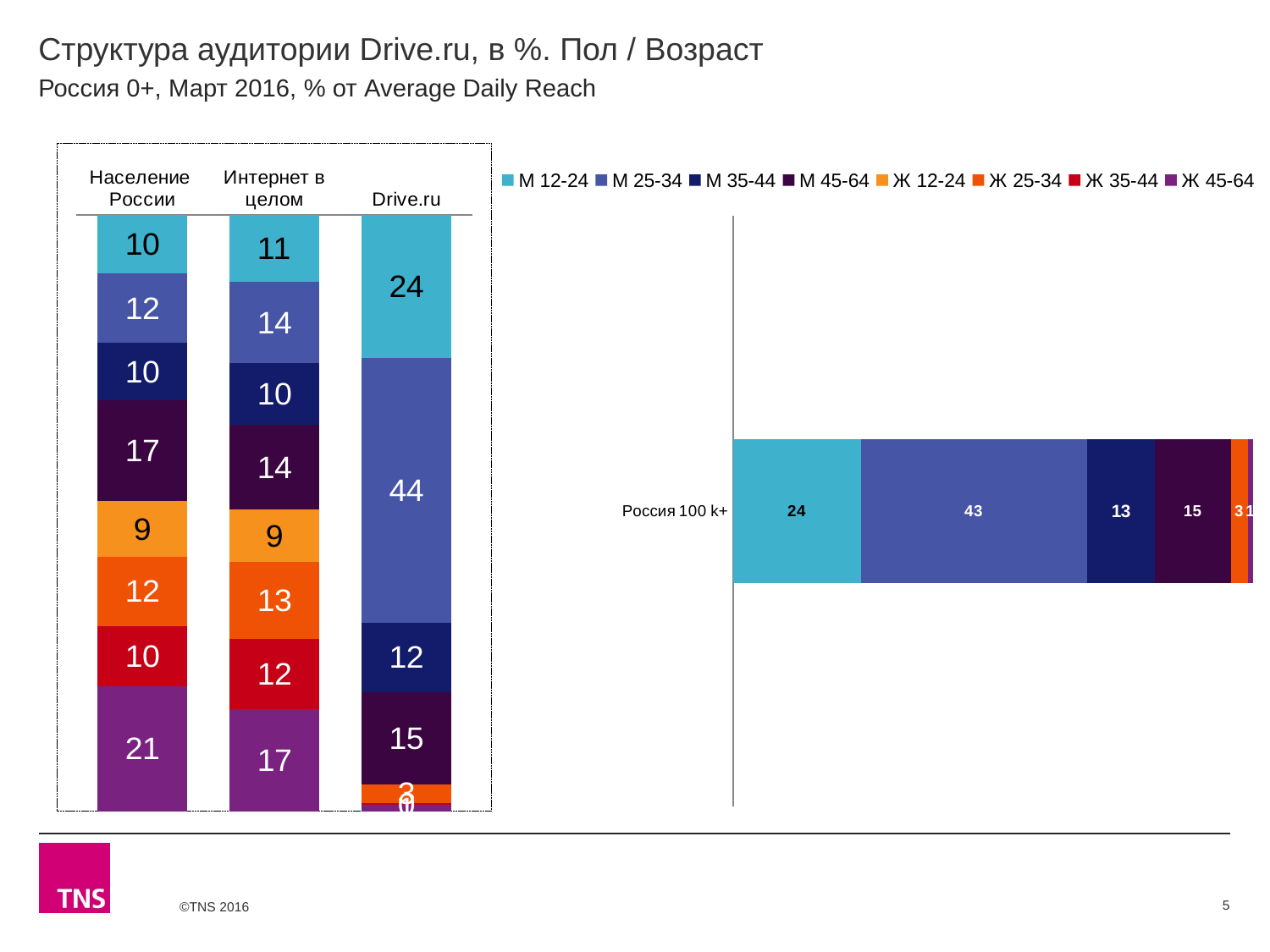
In the left chart, what is the value of Ж 45-64 for Интернет в целом? 17 In the left chart, what is the difference between the М 12-24 value for Drive.ru and the М 12-24 value for Население России? 14 In the right chart, what is the value of М 25-34 for Россия 100 k+? 43 In the left chart, what is the value of М 25-34 for Drive.ru? 44 What kind of chart is the left chart? Stacked bar chart How many categories (bars) are shown in the left chart? 3 In the left chart, which is larger: the М 35-44 value for Drive.ru or for Интернет в целом? Drive.ru In the left chart, which series has the largest value for Население России? Ж 45-64 In the right chart, which series has the largest segment for Россия 100 k+? М 25-34 In the left chart, what is the value of М 45-64 for Население России? 17 How many series does the legend list? 8 In the right chart, what is the value of М 35-44 for Россия 100 k+? 13